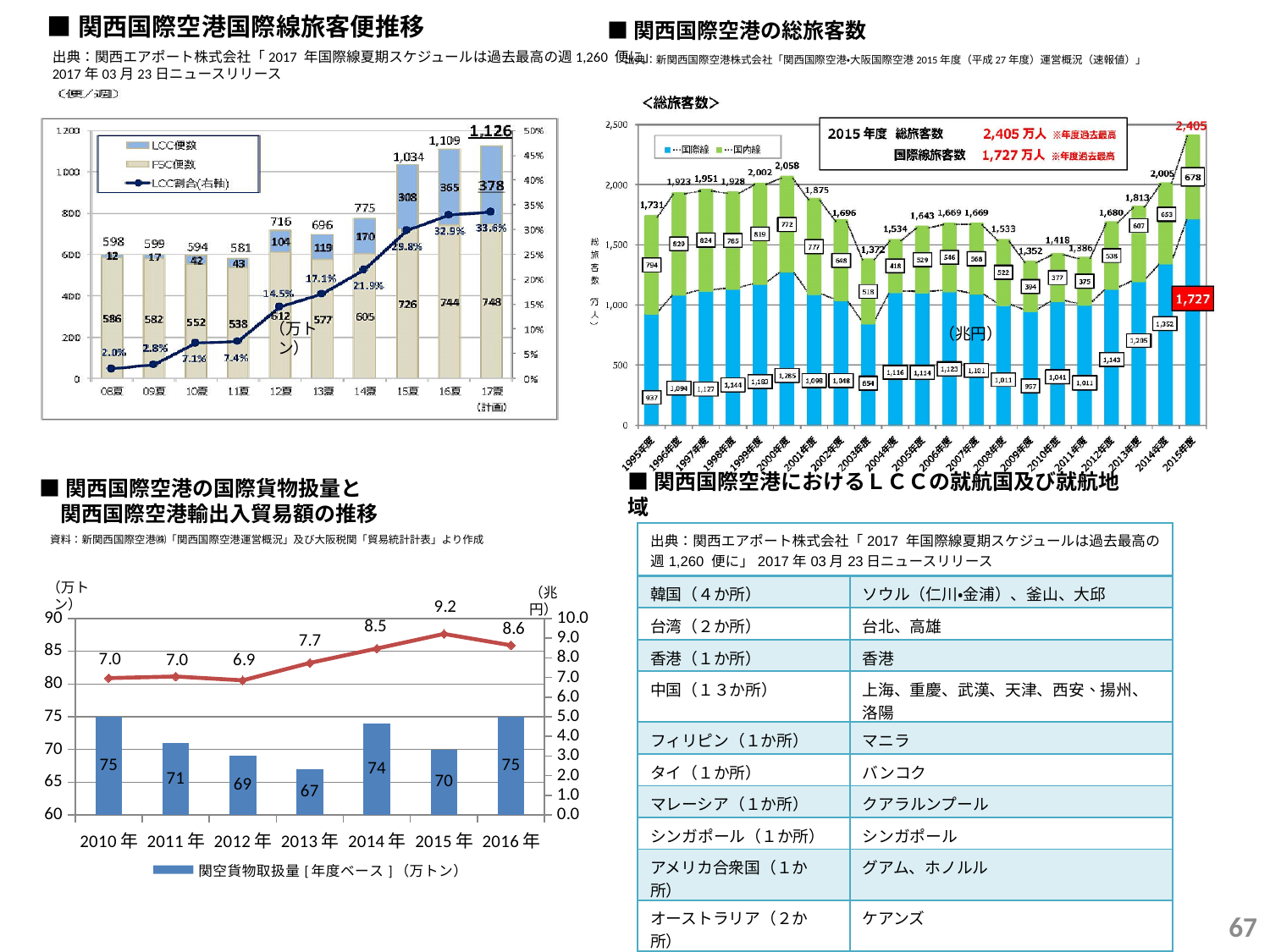
In the bottom-left chart (関西国際空港の国際貨物扱量と関西国際空港輸出入貿易額の推移), which year has the lowest cargo handling volume bar? 2013年 In the top-right chart (関西国際空港の総旅客数), which fiscal year has the lowest total passenger count? 2009年度 In the bottom-left chart (関西国際空港の国際貨物扱量と関西国際空港輸出入貿易額の推移), what is the line value (兆円) for 2015年? 9.2 In the top-right chart (関西国際空港の総旅客数), what is the total passenger count for 2015年度? 2,405 In the top-left chart (関西国際空港国際線旅客便推移), how many series does the legend list? 3 In the bottom-left chart (関西国際空港の国際貨物扱量と関西国際空港輸出入貿易額の推移), what is the difference between the cargo bar values for 2010年 and 2013年? 8 In the bottom-left chart (関西国際空港の国際貨物扱量と関西国際空港輸出入貿易額の推移), what is the cargo handling volume (bar) for 2013年? 67 In the top-left chart (関西国際空港国際線旅客便推移), what is the total number of flights for 15夏? 1,034 In the top-left chart (関西国際空港国際線旅客便推移), what is the LCC share (LCC割合) for 17夏? 33.6% In the bottom-left chart (関西国際空港の国際貨物扱量と関西国際空港輸出入貿易額の推移), how many years are shown on the x axis? 7 In the top-left chart (関西国際空港国際線旅客便推移), does the LCC share line rise or fall from 08夏 to 17夏? rise In the top-right chart (関西国際空港の総旅客数), what is the 国際線 value for 2015年度? 1,727